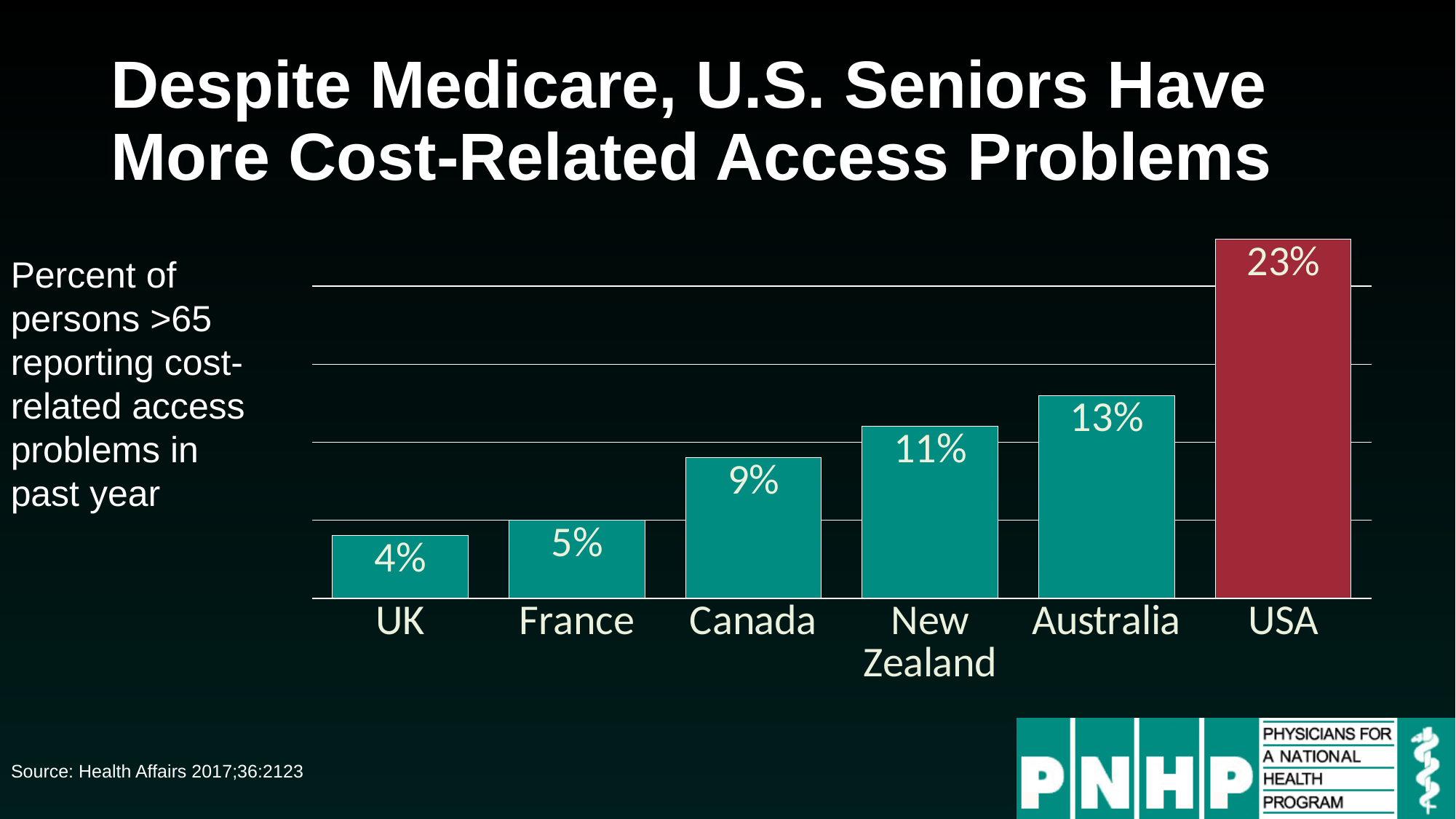
What is the value for Canada? 9% Which country has the highest value? USA How many countries are shown in the chart? 6 Which is larger, the value for Australia or the value for Canada? Australia Do the values rise or fall from left to right across the countries? Rise What kind of chart is shown on the slide? Bar chart Which country has the lowest value? UK What is the value for the UK? 4% Which bar is shown in a different colour (red) from the others? USA What is the difference between the values for the USA and Australia? 10% What is the value for the USA? 23% What is the difference between the values for New Zealand and France? 6%